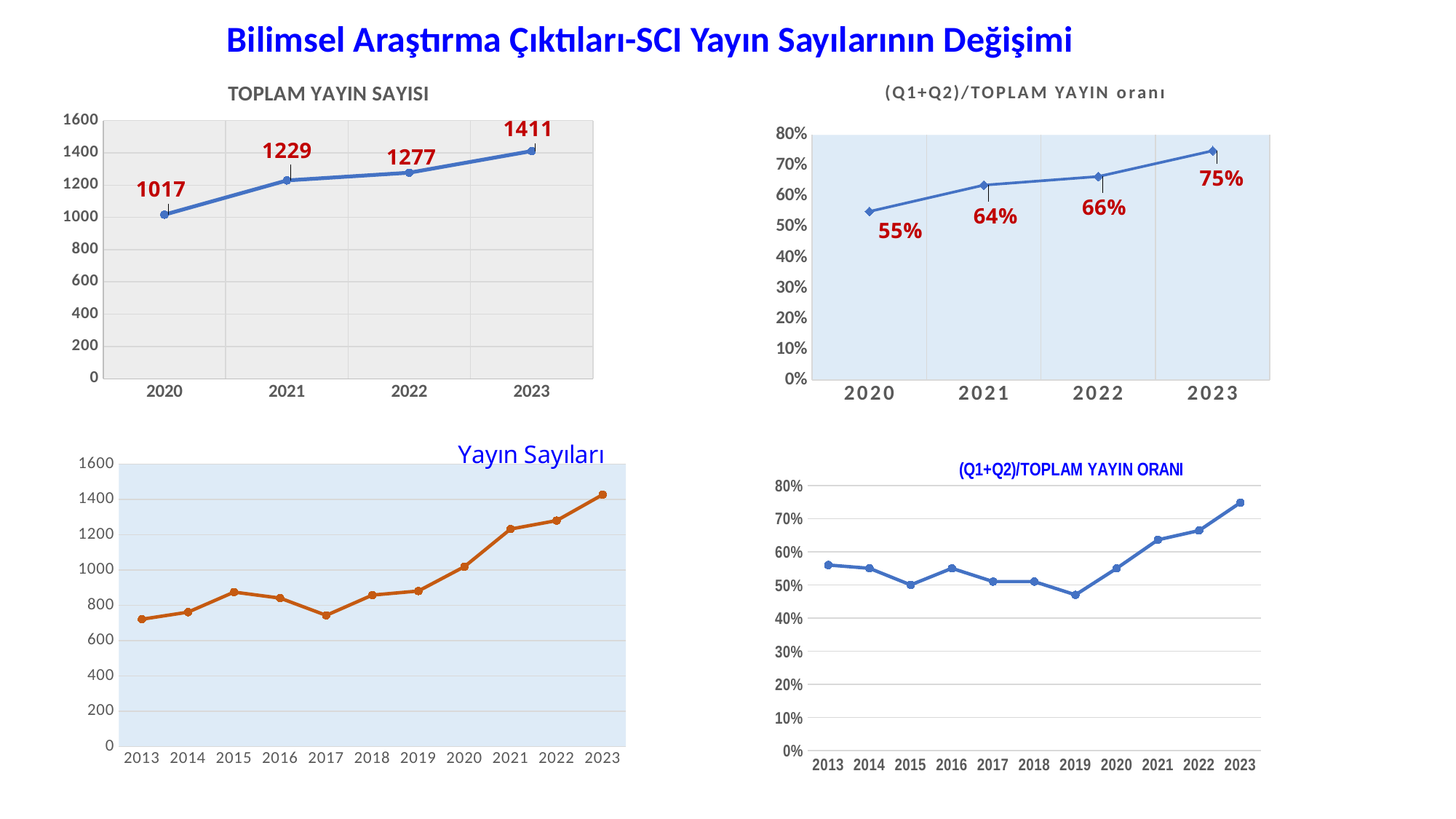
In the '(Q1+Q2)/TOPLAM YAYIN oranı' chart at the top right, do the values rise or fall from 2020 to 2023? rise In the 'TOPLAM YAYIN SAYISI' chart, which year has the highest value? 2023 In the 'TOPLAM YAYIN SAYISI' chart, what is the value for 2021? 1229 In the '(Q1+Q2)/TOPLAM YAYIN oranı' chart at the top right, which year has the lowest value? 2020 What kind of chart is the 'Yayın Sayıları' chart at the bottom left? line chart In the '(Q1+Q2)/TOPLAM YAYIN ORANI' chart at the bottom right, which year has the lowest value? 2019 In the '(Q1+Q2)/TOPLAM YAYIN oranı' chart at the top right, what is the difference between the 2023 and 2020 values? 20% In the 'TOPLAM YAYIN SAYISI' chart, what is the difference between the 2023 and 2022 values? 134 In the 'TOPLAM YAYIN SAYISI' chart, what is the value for 2020? 1017 In the 'Yayın Sayıları' chart at the bottom left, is the value for 2017 greater or less than 800? less In the '(Q1+Q2)/TOPLAM YAYIN oranı' chart at the top right, what is the value for 2022? 66% In the 'Yayın Sayıları' chart at the bottom left, how many years are plotted on the x axis? 11